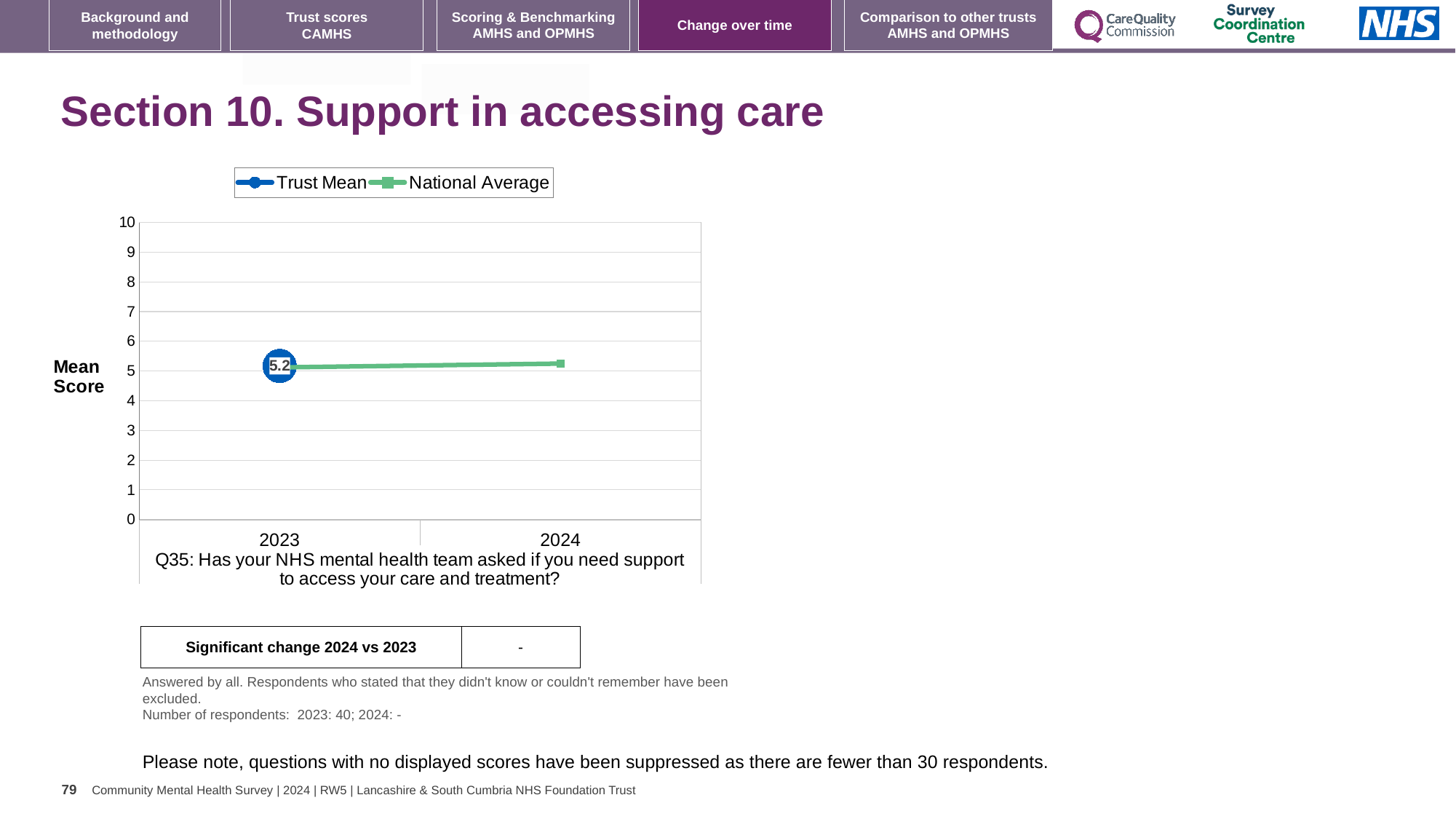
Is the National Average value for 2024 greater or less than 5? greater Is the National Average value for 2024 greater or less than 6? less How many years are shown on the x axis? 2 Is the Trust Mean value for 2023 greater or less than 7? less Which series is shown in green in the chart? National Average What is the label on the y axis of the chart? Mean Score How many series does the legend list? 2 For which year is a Trust Mean data point plotted? 2023 What kind of chart is shown on the slide? line chart What is the Trust Mean value for 2023? 5.2